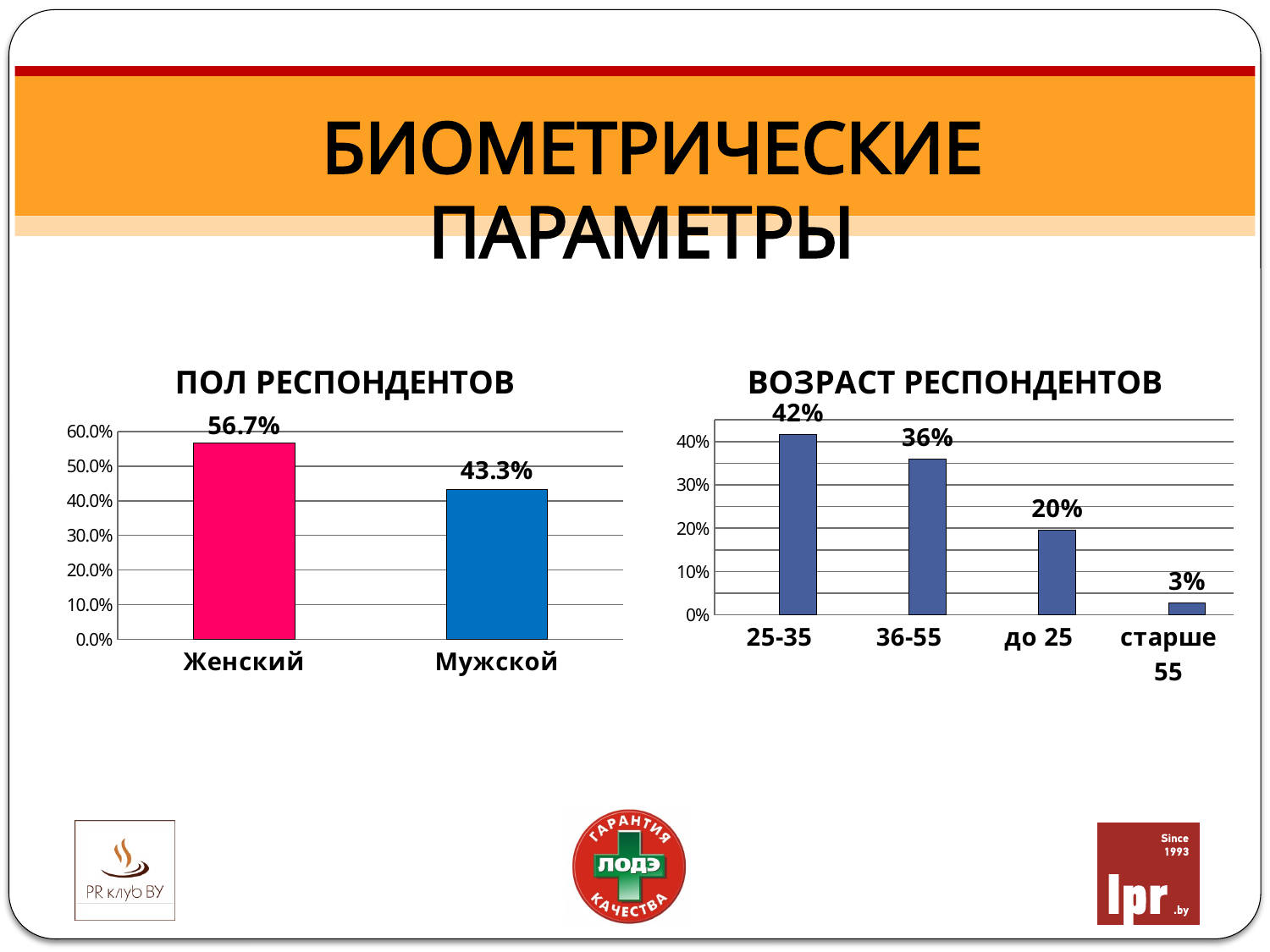
In the 'ВОЗРАСТ РЕСПОНДЕНТОВ' chart, which category has the highest value? 25-35 In the 'ПОЛ РЕСПОНДЕНТОВ' chart, what is the value for Мужской? 43.3% In the 'ПОЛ РЕСПОНДЕНТОВ' chart, what is the value for Женский? 56.7% In the 'ВОЗРАСТ РЕСПОНДЕНТОВ' chart, how many categories are shown? 4 What kind of chart is the 'ВОЗРАСТ РЕСПОНДЕНТОВ' chart? Bar chart In the 'ВОЗРАСТ РЕСПОНДЕНТОВ' chart, what is the value for 36-55? 36% In the 'ВОЗРАСТ РЕСПОНДЕНТОВ' chart, what is the value for старше 55? 3% In the 'ПОЛ РЕСПОНДЕНТОВ' chart, what is the difference between Женский and Мужской? 13.4% In the 'ПОЛ РЕСПОНДЕНТОВ' chart, which category has the highest value? Женский In the 'ВОЗРАСТ РЕСПОНДЕНТОВ' chart, which category has the lowest value? старше 55 In the 'ВОЗРАСТ РЕСПОНДЕНТОВ' chart, what is the difference between 25-35 and до 25? 22% In the 'ПОЛ РЕСПОНДЕНТОВ' chart, how many categories are shown? 2